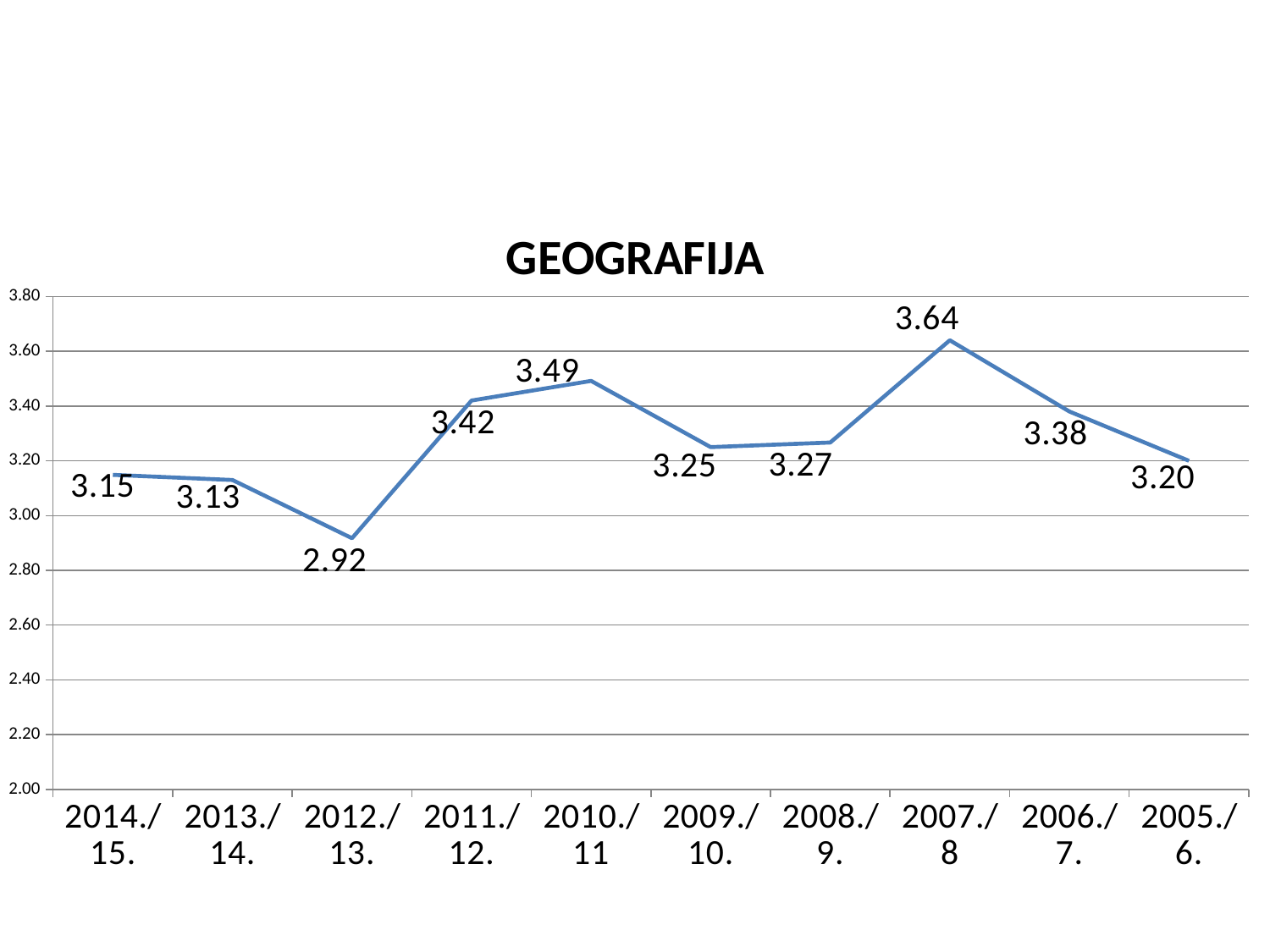
Which category has the highest value? 2007./8 Is the value for 2010./11 greater or less than 3.40? greater What is the title of the chart? GEOGRAFIJA What is the value for 2014./15.? 3.15 What is the value for 2012./13.? 2.92 What is the value for 2007./8? 3.64 What is the value for 2005./6.? 3.20 Which is larger, the value for 2011./12. or the value for 2006./7.? 2011./12. What is the difference between the values for 2007./8 and 2012./13.? 0.72 What kind of chart is this? line chart How many categories are shown on the x axis? 10 Which category has the lowest value? 2012./13.